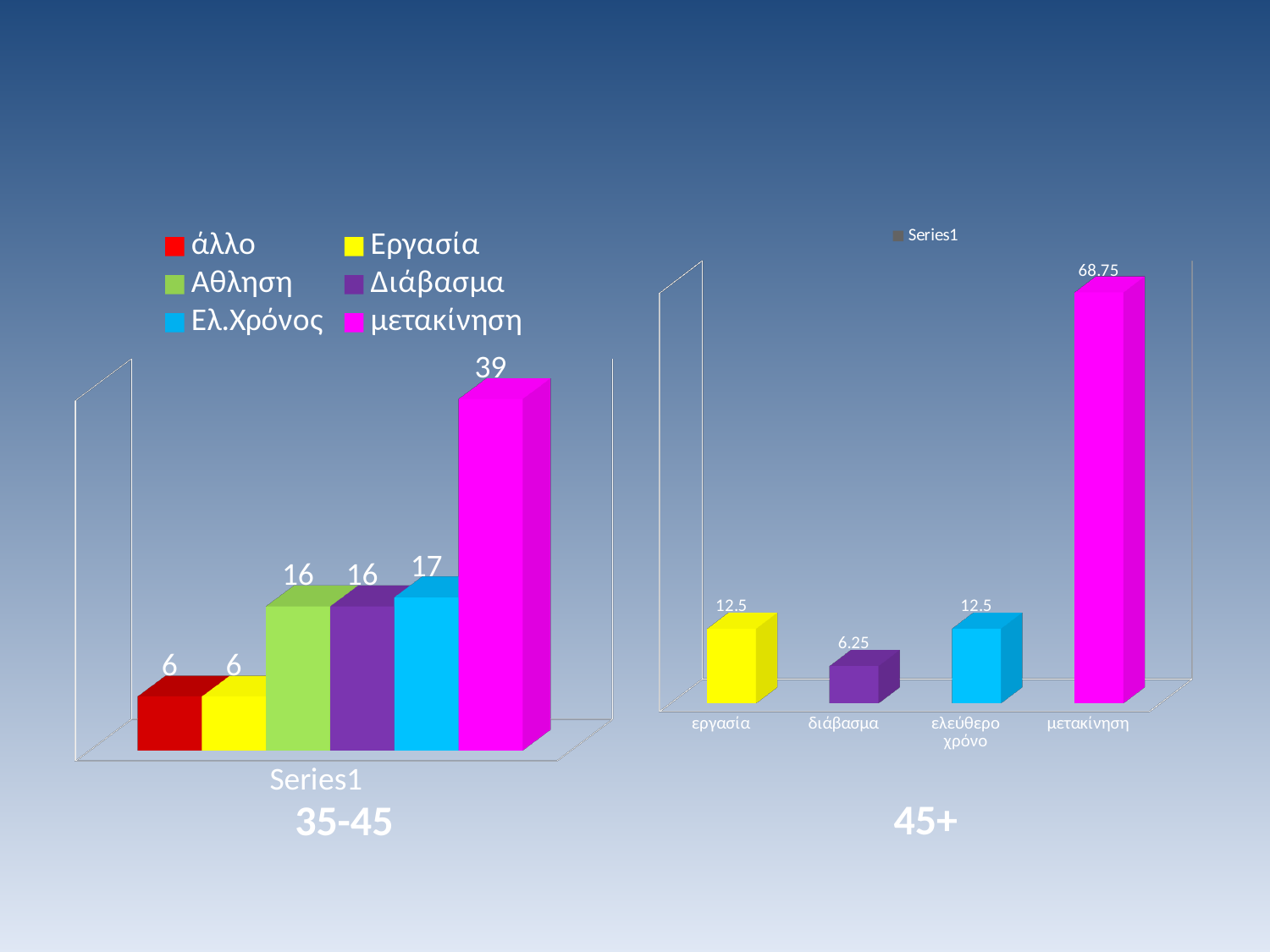
In the 45+ chart, what is the difference between μετακίνηση and εργασία? 56.25 In the 45+ chart, what is the value for διάβασμα? 6.25 In the 35-45 chart, what is the value for άλλο? 6 In the 45+ chart, what is the value for μετακίνηση? 68.75 In the 35-45 chart, which category has the highest value? μετακίνηση In the 45+ chart, which category has the lowest value? διάβασμα In the 35-45 chart, what is the value for Ελ.Χρόνος? 17 In the 35-45 chart, what is the value for μετακίνηση? 39 In the 45+ chart, how many categories are shown on the x axis? 4 In the 35-45 chart, how many legend entries are listed? 6 What kind of chart is the 45+ chart? bar chart In the 35-45 chart, what is the difference between μετακίνηση and Ελ.Χρόνος? 22